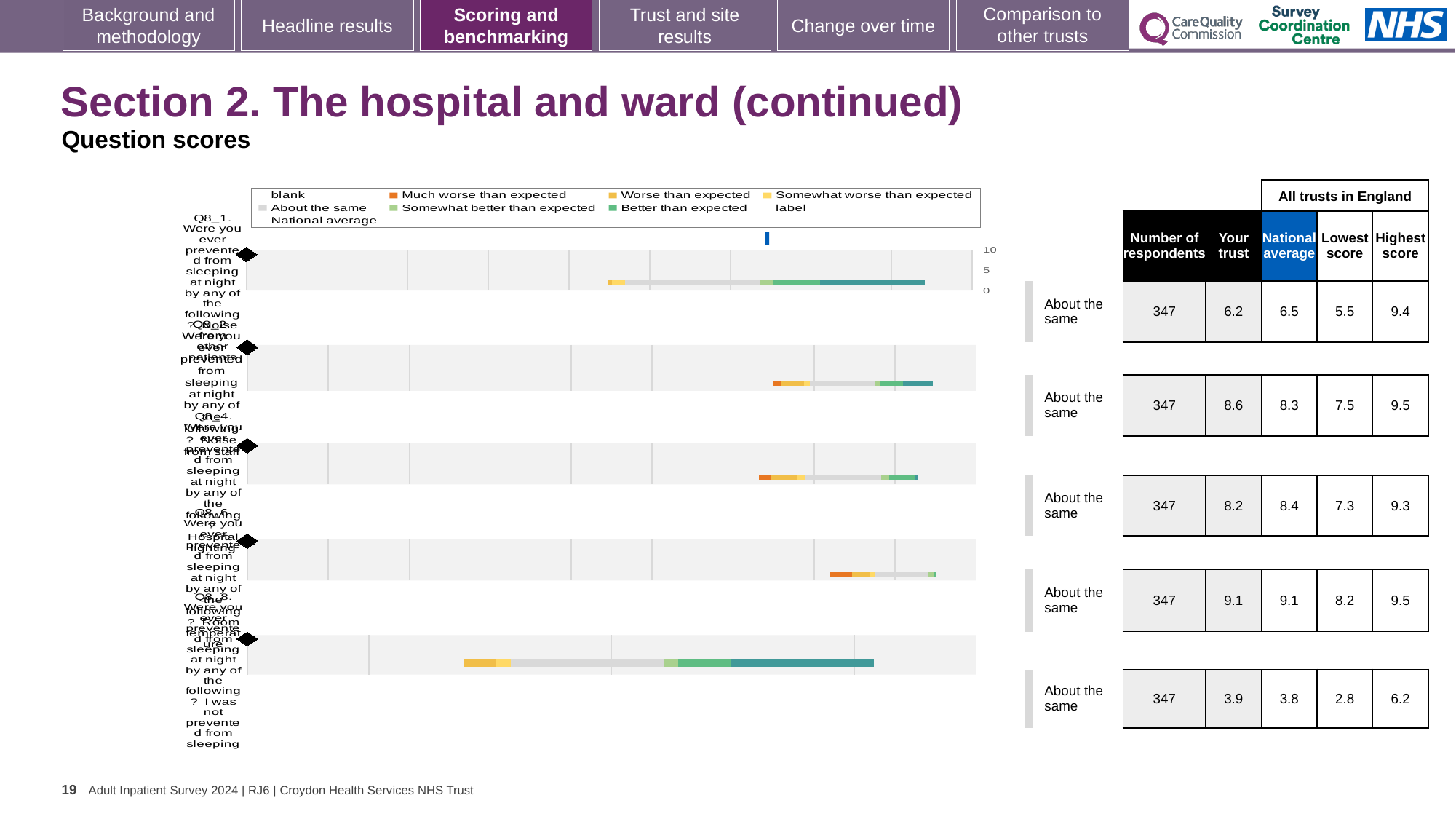
What benchmark label is shown beside every bar in the chart? About the same How many question rows (bars) does the chart show? 5 Which row has the lowest 'Your trust' score in the table next to the chart? the bottom (fifth) row In the table next to the chart, what is the 'Your trust' score for the top row? 6.2 In the table next to the chart, what is the number of respondents for the top row? 347 For the bottom row, what is the difference between the highest score and the lowest score in the table? 3.4 Which legend entry is shown in dark orange? Much worse than expected How many entries does the chart's legend list? 9 Which row has the highest 'Your trust' score in the table next to the chart? the fourth row In the table next to the chart, what is the national average for the bottom row? 3.8 What kind of chart is shown on the slide? bar chart For the top row, which is larger: the 'Your trust' score or the national average? national average